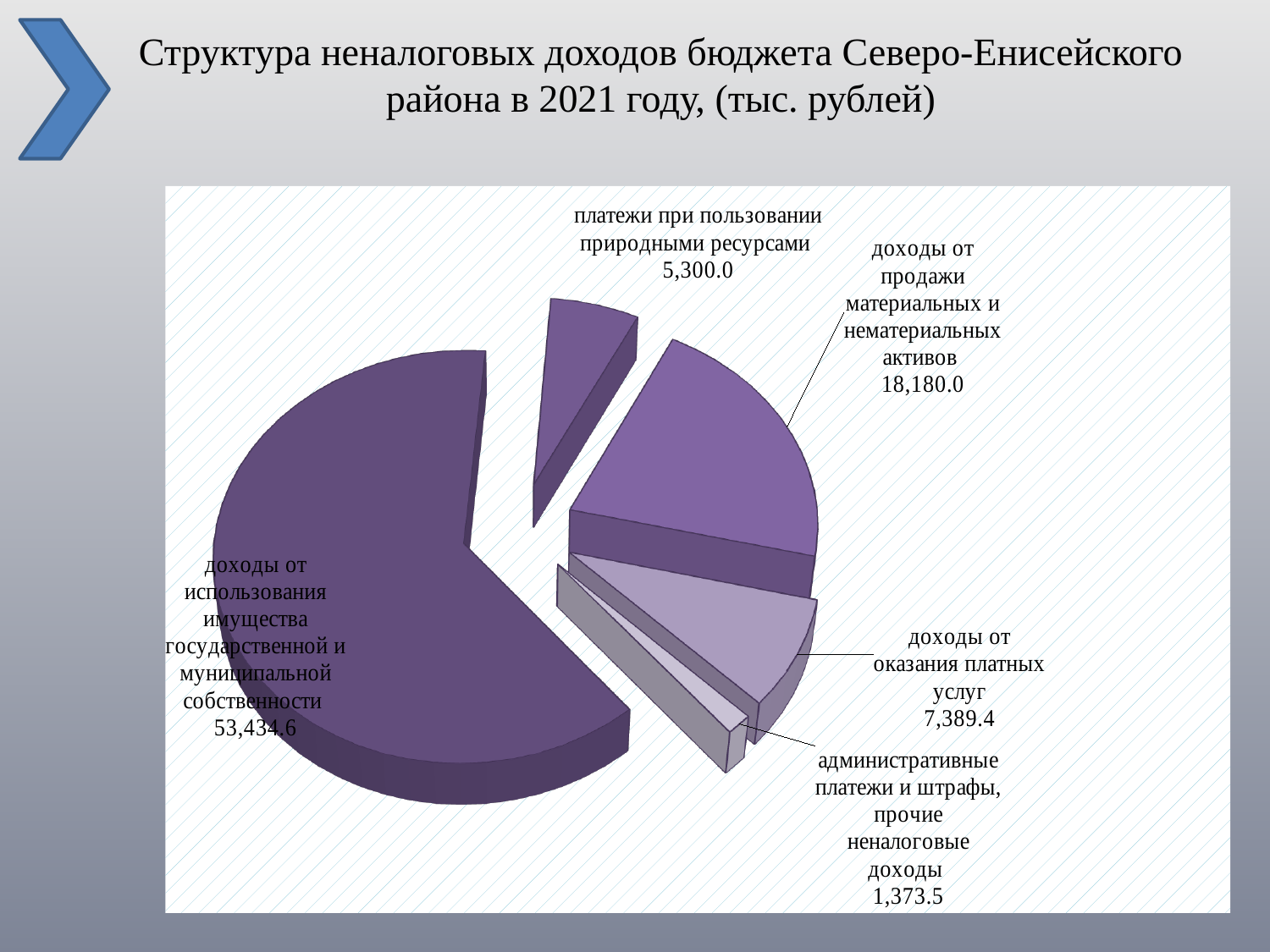
Which category has the smallest slice of the pie? административные платежи и штрафы, прочие неналоговые доходы What is the value for доходы от продажи материальных и нематериальных активов? 18,180.0 What is the value for доходы от оказания платных услуг? 7,389.4 What is the value for доходы от использования имущества государственной и муниципальной собственности? 53,434.6 What is the value for платежи при пользовании природными ресурсами? 5,300.0 What kind of chart is shown on the slide? Pie chart What is the value for административные платежи и штрафы, прочие неналоговые доходы? 1,373.5 Which is larger: доходы от оказания платных услуг or платежи при пользовании природными ресурсами? доходы от оказания платных услуг Which category has the largest slice of the pie? доходы от использования имущества государственной и муниципальной собственности What is the title of the chart on the slide? Структура неналоговых доходов бюджета Северо-Енисейского района в 2021 году, (тыс. рублей) What is the difference between доходы от использования имущества государственной и муниципальной собственности and доходы от продажи материальных и нематериальных активов? 35,254.6 How many slices does the pie chart have? 5